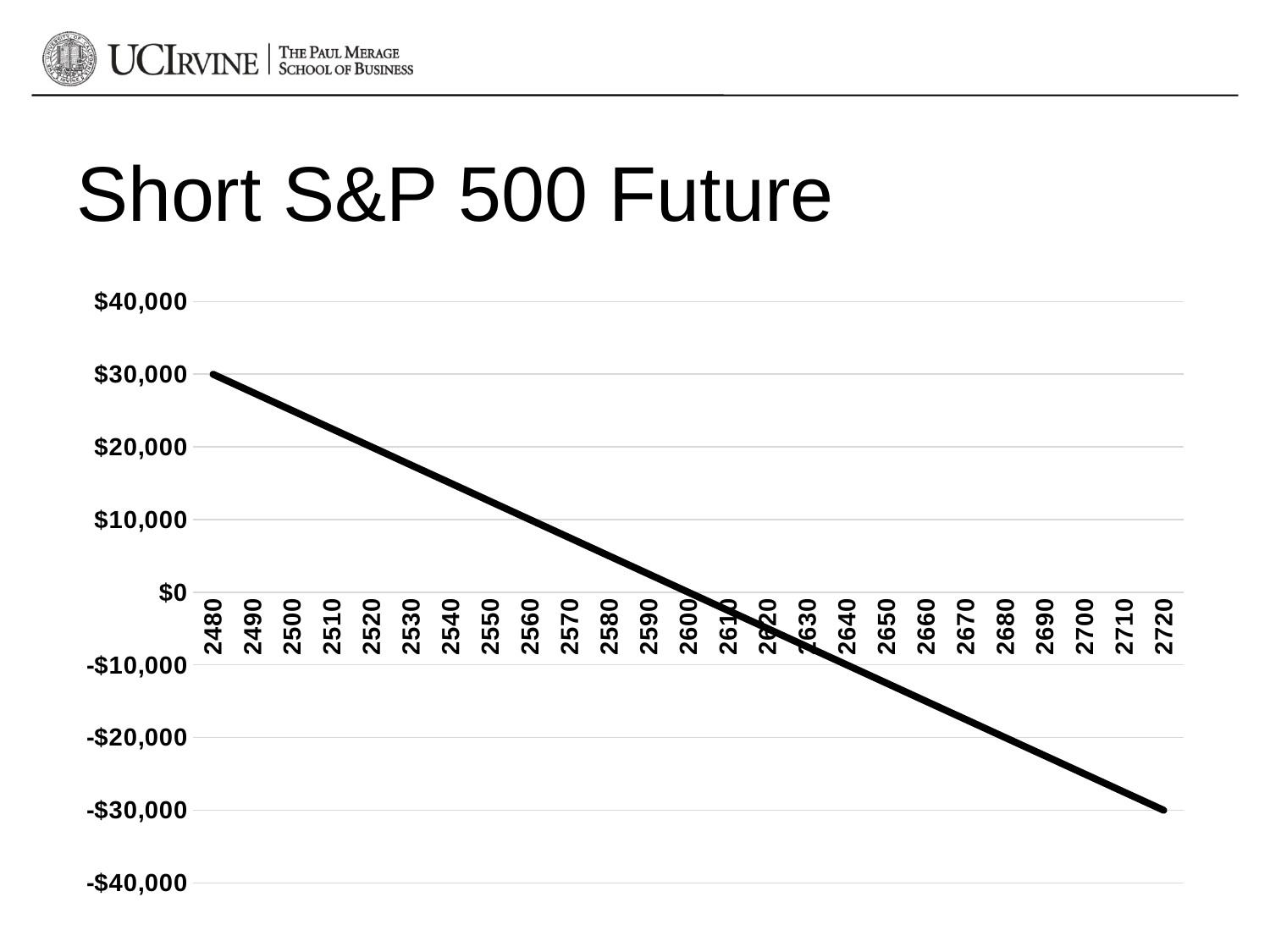
Which has the larger value, 2500 or 2700? 2500 Does the line rise or fall as the S&P 500 level increases along the x axis? fall How many x-axis values are labelled on the chart? 25 At which x-axis value is the line at its highest? 2480 What is the title of the slide's chart? Short S&P 500 Future What is the value of the line at an S&P 500 level of 2720? -$30,000 What is the difference between the value at 2480 and the value at 2720? $60,000 At which x-axis value is the line at its lowest? 2720 Is the value at 2500 greater or less than $20,000? greater Is the value at 2650 greater or less than -$10,000? less What kind of chart is shown on the slide? line chart What is the value of the line at an S&P 500 level of 2480? $30,000